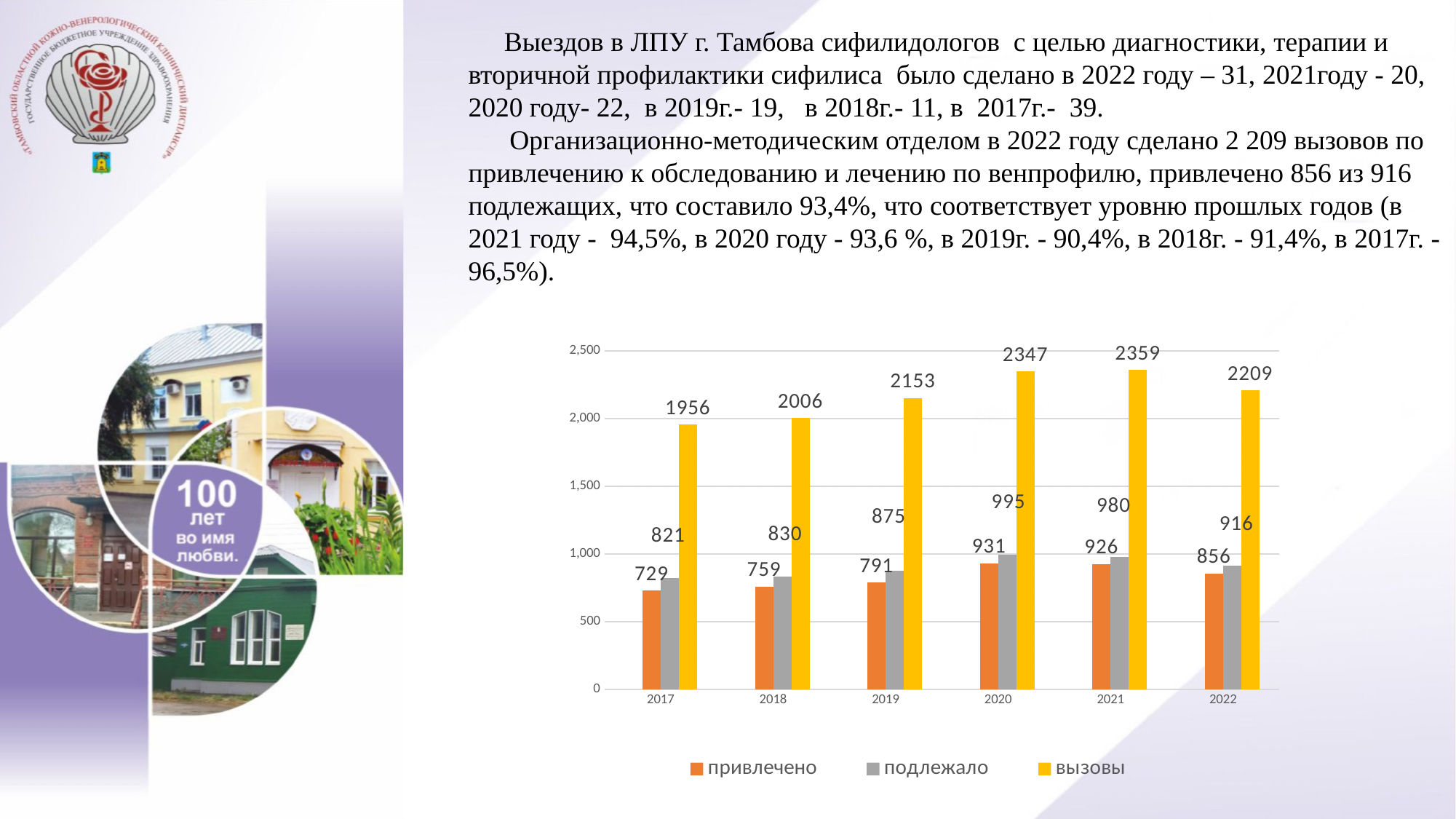
What kind of chart is shown on the slide? bar chart What is the value of the "вызовы" series for 2022? 2209 Is the "вызовы" value for 2017 greater or less than 2,000? less Which colour represents the "вызовы" series in the chart? yellow In which year is the "привлечено" series lowest? 2017 Which is larger: the "вызовы" value for 2020 or for 2019? 2020 How many series does the chart legend list? 3 What is the value of the "привлечено" series for 2017? 729 How many years are shown on the x axis of the chart? 6 In which year is the "вызовы" series highest? 2021 What is the value of the "подлежало" series for 2020? 995 What is the difference between "подлежало" and "привлечено" in 2022? 60